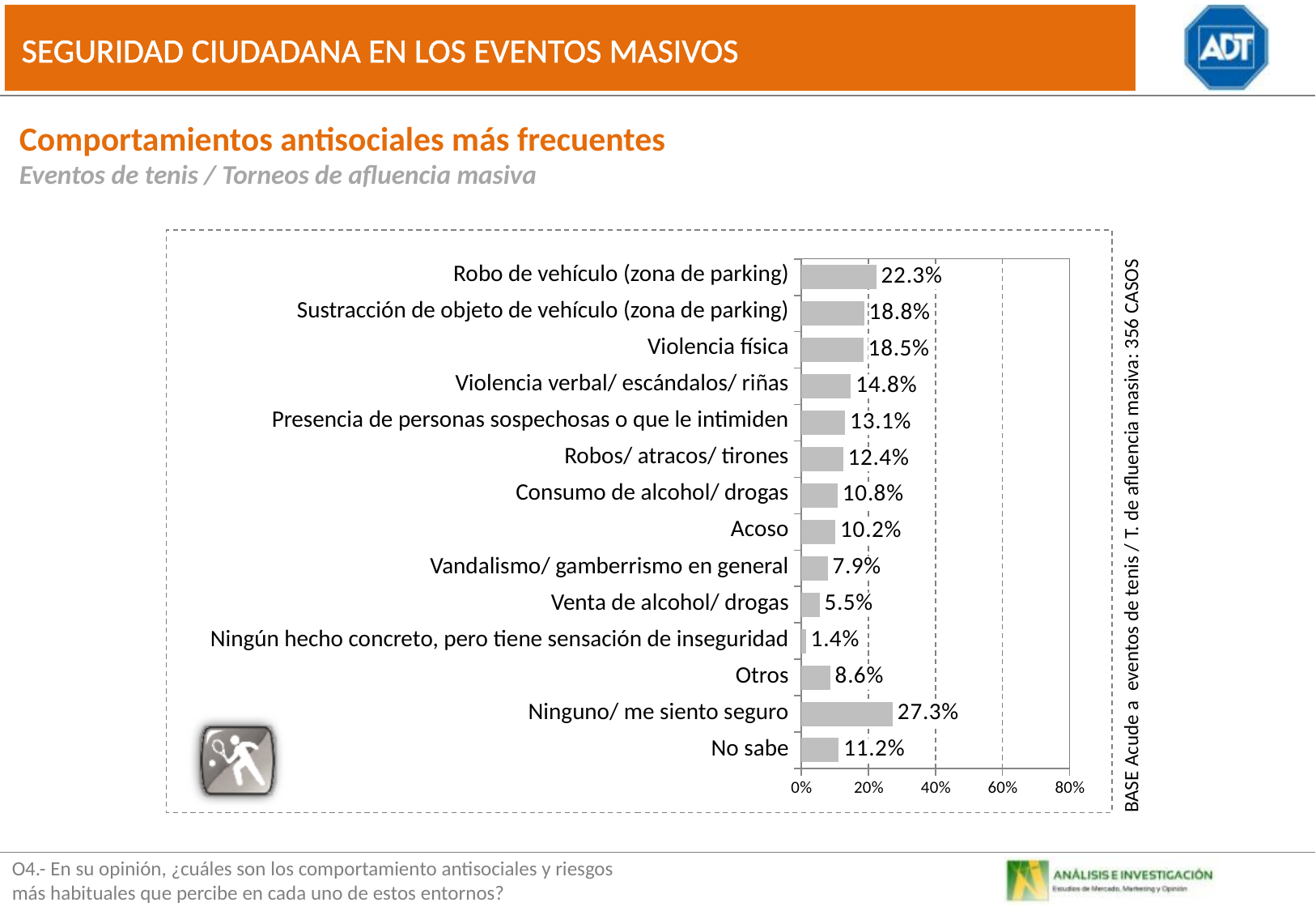
How many categories are shown in the chart? 14 What is the base (number of cases) stated beside the chart? 356 CASOS What is the value for "Robo de vehículo (zona de parking)"? 22.3% What is the value for "Violencia física"? 18.5% What is the value for "Ninguno/ me siento seguro"? 27.3% What is the difference between "Robo de vehículo (zona de parking)" and "Sustracción de objeto de vehículo (zona de parking)"? 3.5% Which is larger, "Acoso" or "Otros"? Acoso What is the value for "Venta de alcohol/ drogas"? 5.5% What kind of chart is shown on the slide? Bar chart Which category has the lowest value? Ningún hecho concreto, pero tiene sensación de inseguridad Which category has the highest value? Ninguno/ me siento seguro Is the value for "Ninguno/ me siento seguro" greater or less than 20%? greater